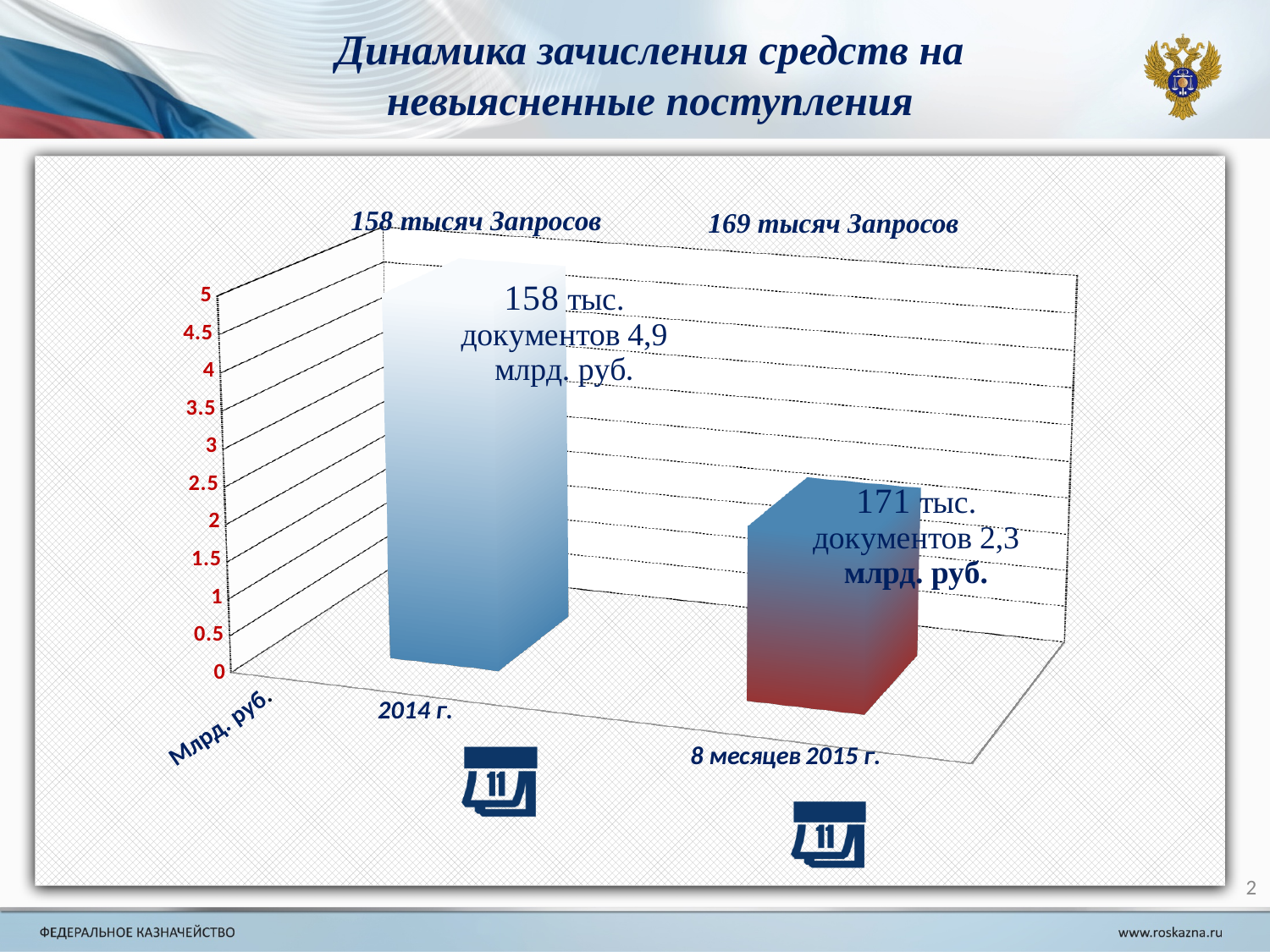
What is the difference between the 2014 г. value and the 8 месяцев 2015 г. value? 2,6 млрд. руб. How many bars (categories) does the chart show? 2 Do the values rise or fall from 2014 г. to 8 месяцев 2015 г.? fall Which category has the lowest value? 8 месяцев 2015 г. What value in млрд. руб. is shown for 8 месяцев 2015 г.? 2,3 млрд. руб. Is the value for 2014 г. greater or less than 4? greater Which category has the higher value, 2014 г. or 8 месяцев 2015 г.? 2014 г. How many thousand documents are noted for 2014 г.? 158 тыс. What kind of chart is shown on the slide? bar chart What value in млрд. руб. is shown for 2014 г.? 4,9 млрд. руб. What unit is labelled on the vertical axis? Млрд. руб. Is the value for 8 месяцев 2015 г. greater or less than 3? less